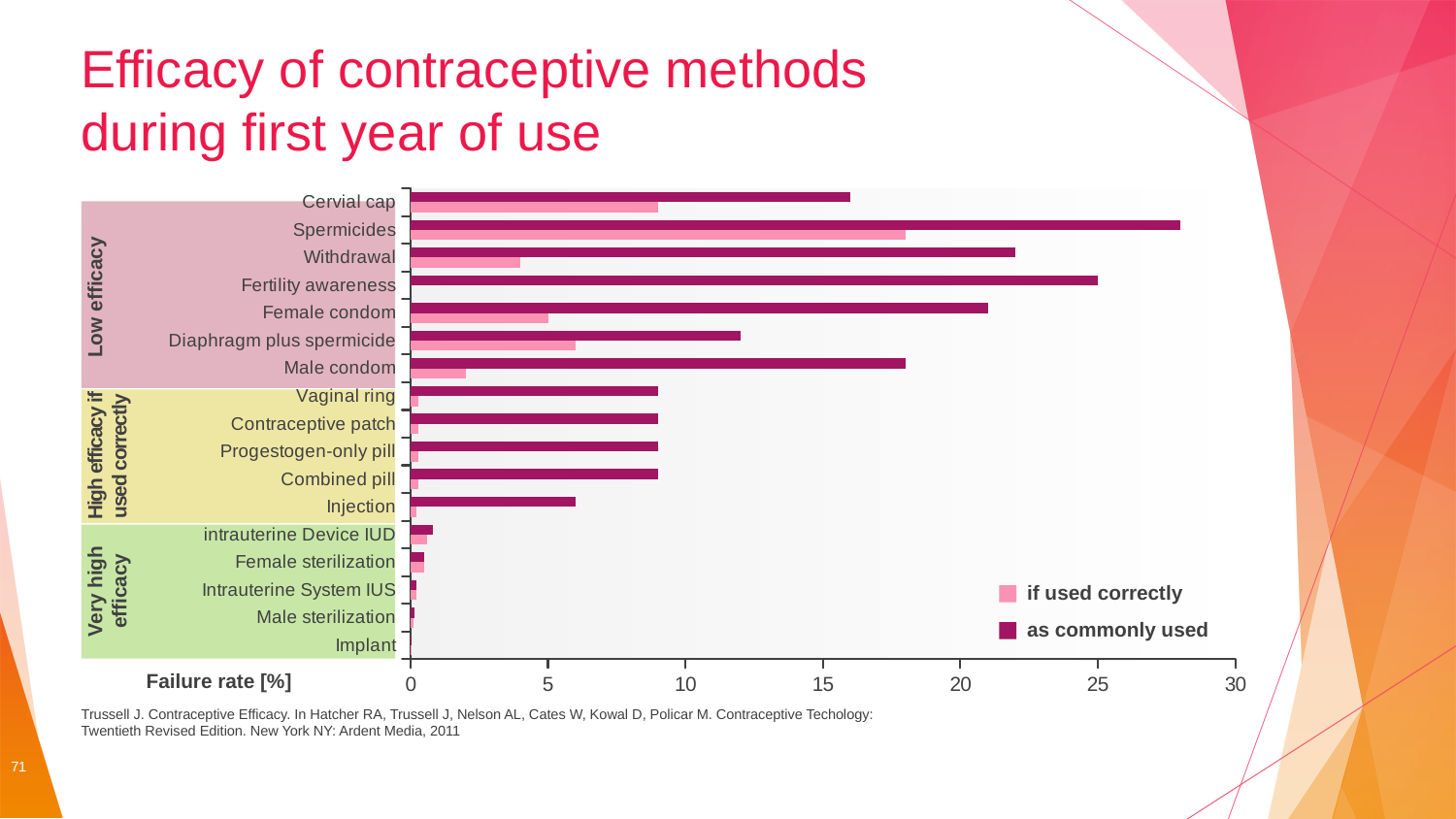
Is the 'as commonly used' failure rate for Male condom greater or less than 15? greater Is the 'as commonly used' failure rate for Diaphragm plus spermicide greater or less than 10? greater Is the 'as commonly used' failure rate for Fertility awareness greater or less than 20? greater What kind of chart is shown on the slide? bar chart Which method has the highest failure rate in the 'as commonly used' series? Spermicides Which method has the highest failure rate in the 'if used correctly' series? Spermicides Which has the larger 'as commonly used' failure rate, Cervial cap or Diaphragm plus spermicide? Cervial cap What is the label of the horizontal axis? Failure rate [%] How many contraceptive methods are listed on the chart? 17 Which has the larger 'as commonly used' failure rate, Fertility awareness or Male condom? Fertility awareness How many series does the legend list? 2